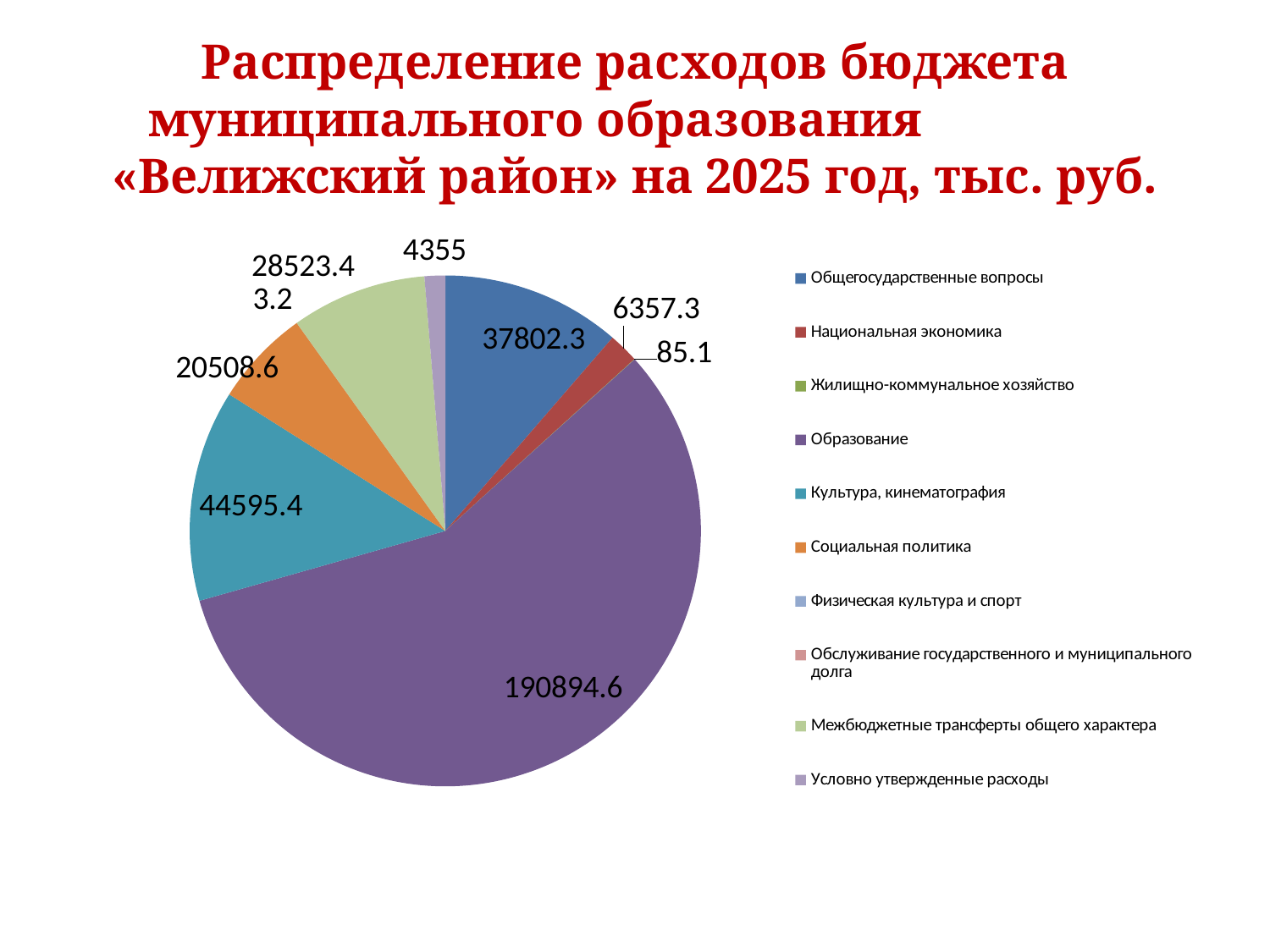
What is the value for Образование? 190894.6 Which category has the largest slice of the pie? Образование What is the value for Национальная экономика? 6357.3 What type of chart is shown on the slide? pie chart What is the value for Социальная политика? 20508.6 What is the value for Культура, кинематография? 44595.4 What is the value for Условно утвержденные расходы? 4355 How many categories does the legend list? 10 What is the value for Межбюджетные трансферты общего характера? 28523.4 What is the difference between the values for Культура, кинематография and Общегосударственные вопросы? 6793.1 What is the value for Общегосударственные вопросы? 37802.3 Which is larger, Культура, кинематография or Социальная политика? Культура, кинематография